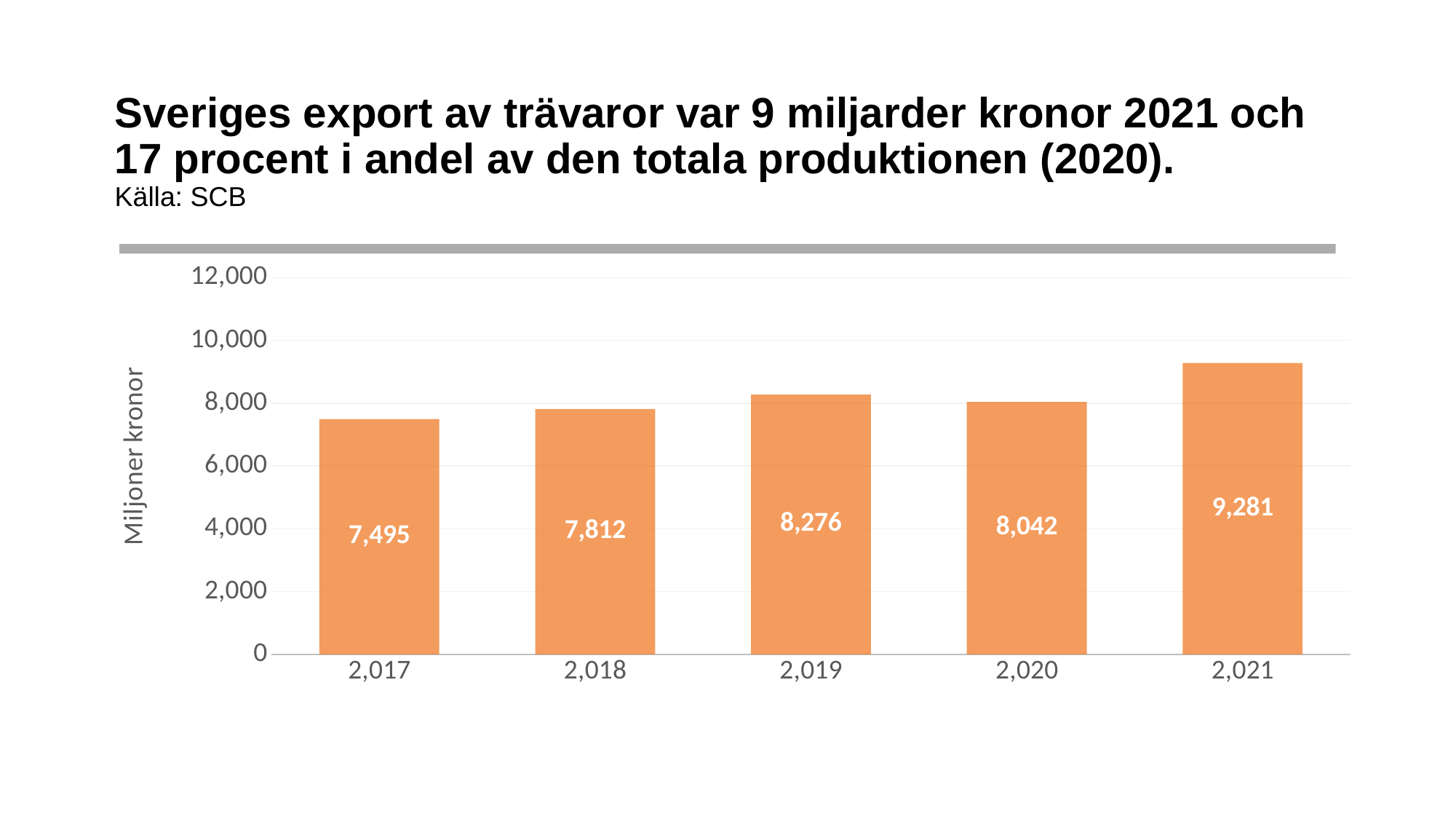
What kind of chart is shown on the slide? bar chart What is the value for 2,019? 8,276 Which year has the highest value? 2,021 What is the value for 2,021? 9,281 Which is larger, the value for 2,019 or the value for 2,020? 2,019 Is the value for 2,021 greater or less than 10,000? less Which year has the lowest value? 2,017 What is the difference between the values for 2,021 and 2,020? 1,239 What is the difference between the values for 2,019 and 2,018? 464 What is the label of the vertical axis? Miljoner kronor How many bars are shown in the chart? 5 What is the value for 2,017? 7,495